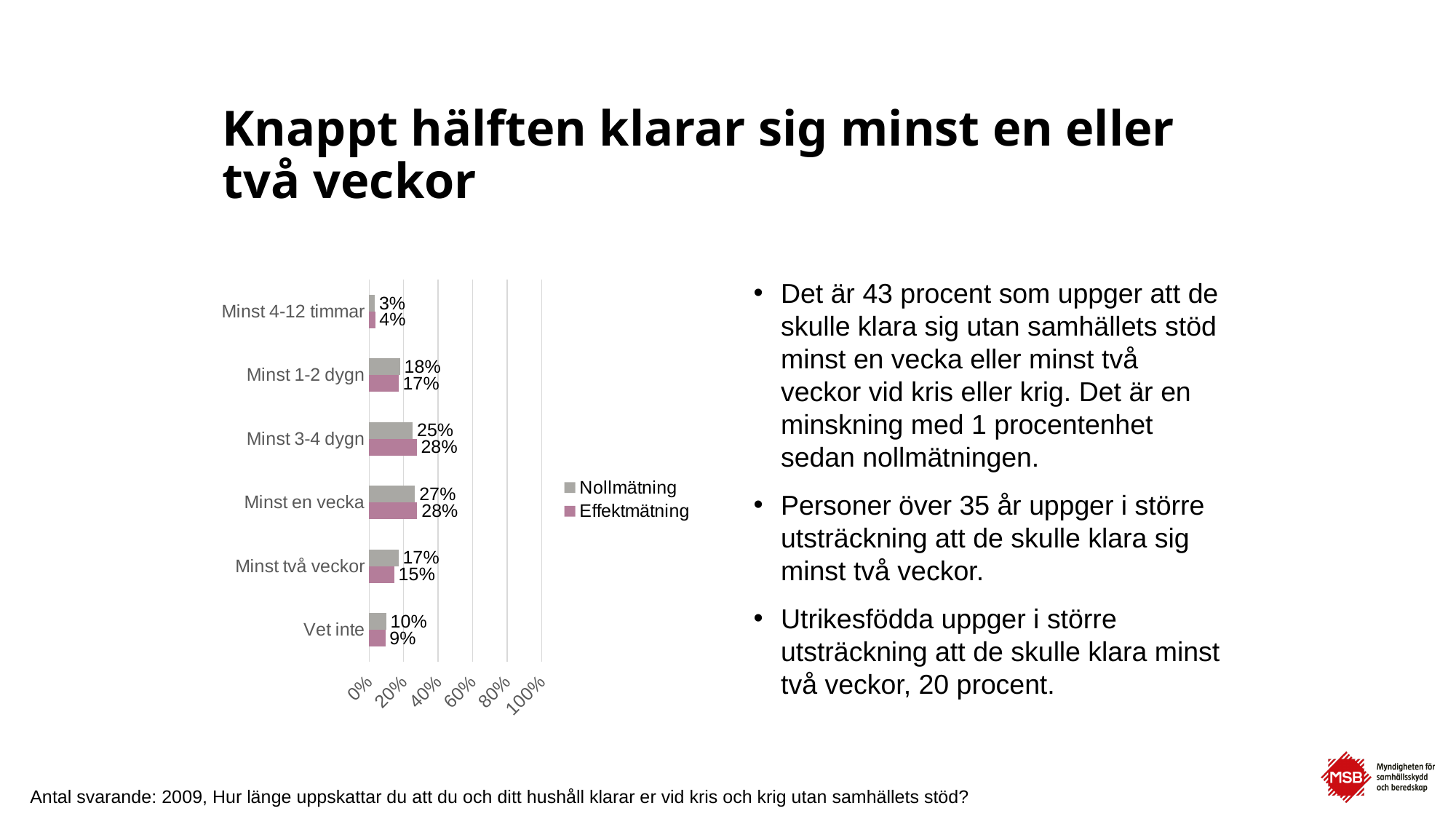
Which category has the highest Nollmätning value? Minst en vecka What is the difference between the Nollmätning and Effektmätning values for Minst 3-4 dygn? 3% What are the two series named in the legend? Nollmätning and Effektmätning What kind of chart is shown on the slide? Bar chart What is the Effektmätning value for Minst 3-4 dygn? 28% How many categories are shown on the chart? 6 How many series does the legend list? 2 Which category has the lowest Nollmätning value? Minst 4-12 timmar What is the Nollmätning value for Minst två veckor? 17% Which is larger for Minst två veckor: the Nollmätning value or the Effektmätning value? Nollmätning Is the Effektmätning value for Minst en vecka greater or less than 20%? greater What is the Nollmätning value for Vet inte? 10%